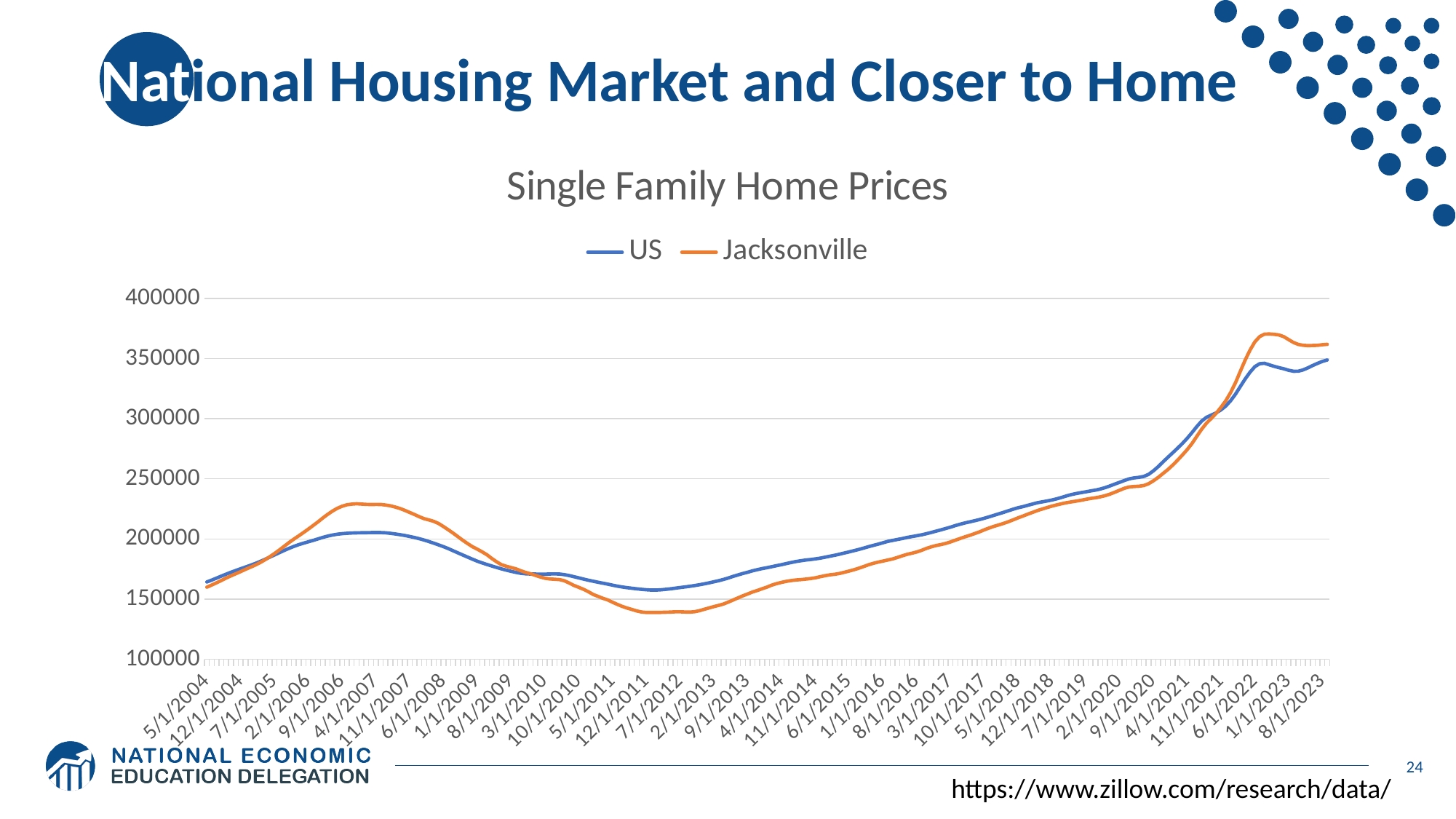
What is the title of the chart? Single Family Home Prices At 7/1/2012, which series has the higher value, US or Jacksonville? US What kind of chart is shown on the slide? line chart Is the value for US at 7/1/2012 greater or less than 200000? less Does the US series rise or fall between 7/1/2012 and 6/1/2022? rise Is the value for Jacksonville at 4/1/2007 greater or less than 200000? greater Does the Jacksonville series rise or fall between 4/1/2007 and 7/1/2012? fall Which series is drawn in orange? Jacksonville Is the value for Jacksonville at 7/1/2012 greater or less than 150000? less How many series does the legend list? 2 At 4/1/2007, which series has the higher value, US or Jacksonville? Jacksonville